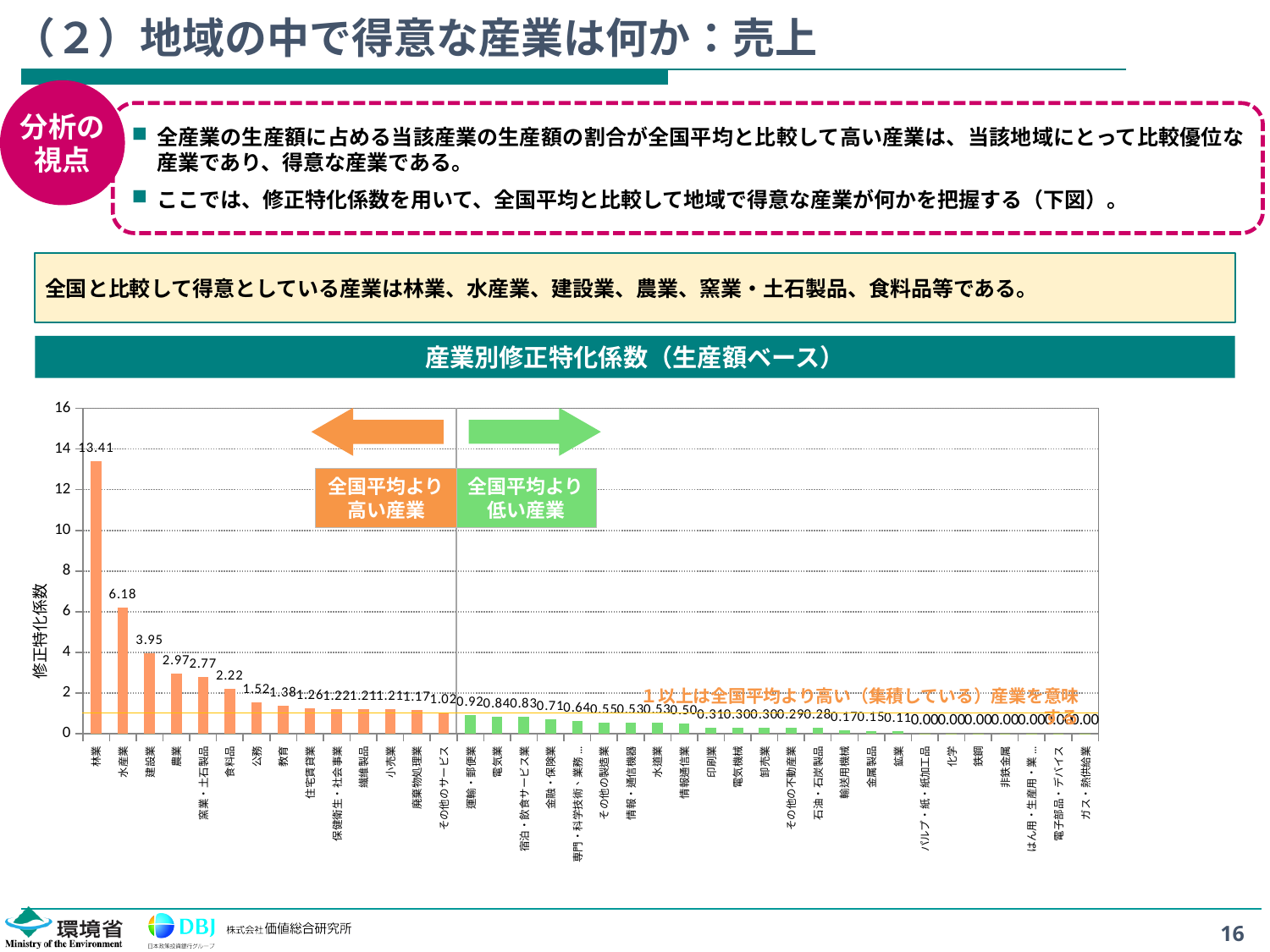
Do the values rise or fall moving from left to right along the x axis? fall What is the value for 鉱業 in the chart? 0.11 What is the difference between the values for 林業 and 水産業? 7.23 What kind of chart is shown on the slide? bar chart What is the value for 食料品 in the chart? 2.22 Which industry has the highest 修正特化係数 in the chart? 林業 What is the value for 林業 in the chart? 13.41 Is the value for 建設業 greater or less than 2? greater What is the label on the vertical axis of the chart? 修正特化係数 Which has a larger value, 農業 or 窯業・土石製品? 農業 What is the value for 建設業 in the chart? 3.95 What is the value for 水産業 in the chart? 6.18